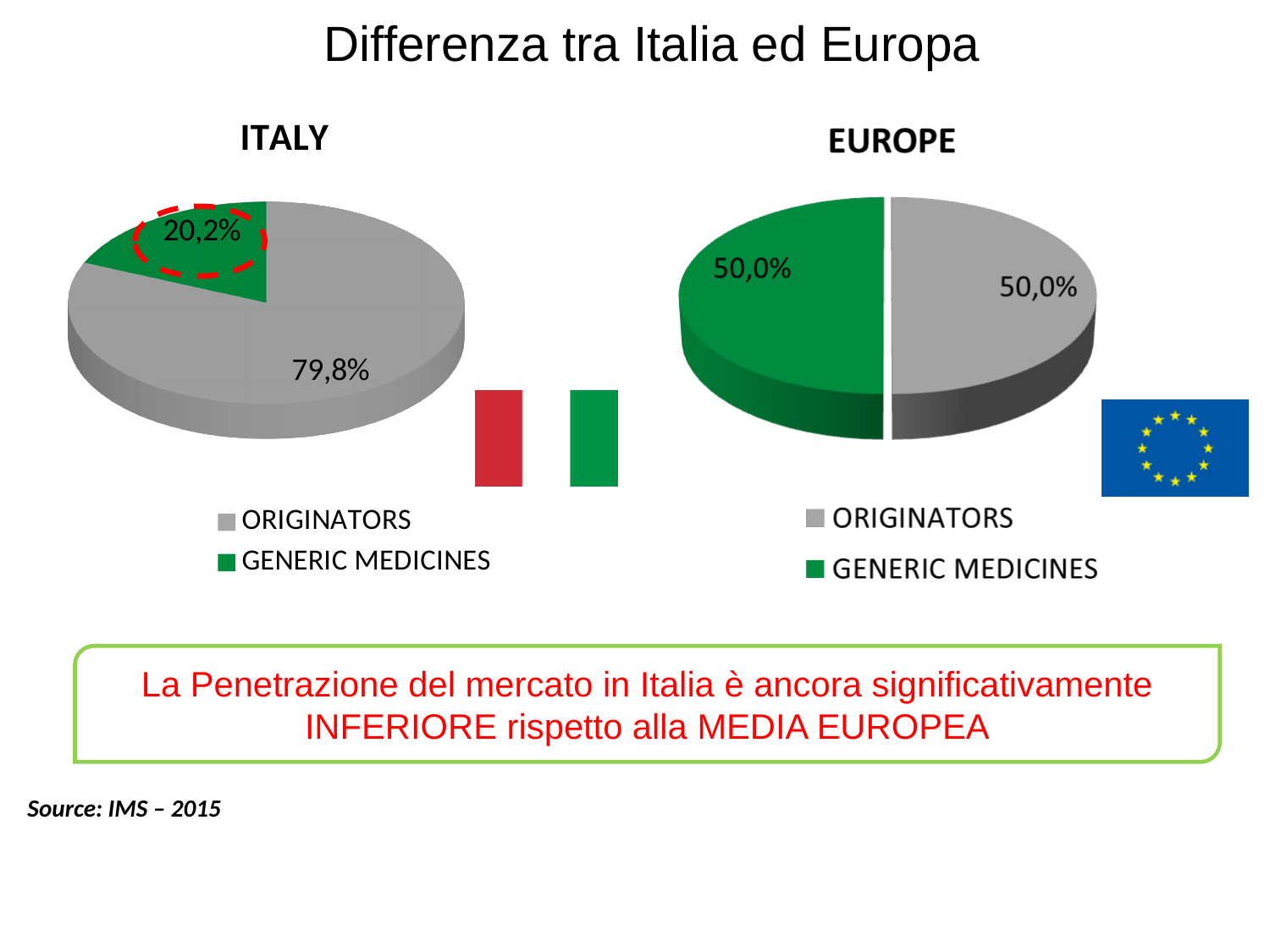
What kind of chart is the ITALY chart? Pie chart In the ITALY chart, which category has the smallest slice? GENERIC MEDICINES In the EUROPE chart, what share do ORIGINATORS have? 50,0% In the ITALY chart, what share do ORIGINATORS have? 79,8% In the EUROPE chart, what share do GENERIC MEDICINES have? 50,0% Which is larger: the GENERIC MEDICINES share in the ITALY chart or in the EUROPE chart? EUROPE In the ITALY chart, what is the difference between the ORIGINATORS share and the GENERIC MEDICINES share? 59,6% In the ITALY chart, which category has the largest slice? ORIGINATORS In the ITALY chart, what share do GENERIC MEDICINES have? 20,2% How many slices does the EUROPE chart have? 2 How many entries does the legend of the ITALY chart list? 2 In the EUROPE chart, what colour is the GENERIC MEDICINES slice? Green